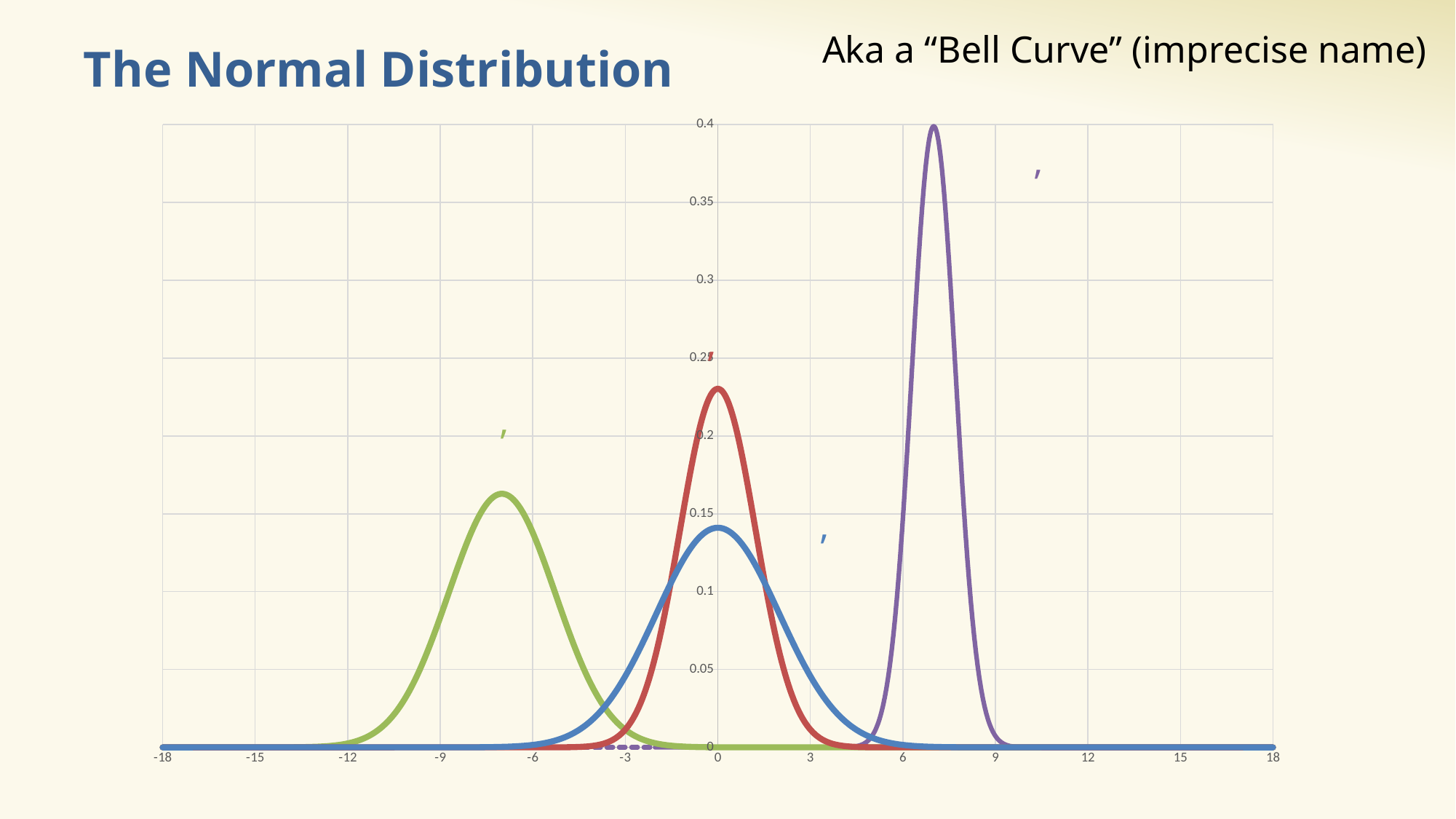
Which curve reaches the highest peak? the purple curve What is the highest value shown on the y axis? 0.4 What is the title of the chart slide? The Normal Distribution How many curves are plotted on the chart? 4 Is the peak of the green curve greater or less than 0.2? less Is the peak of the blue curve greater or less than 0.15? less Is the peak of the purple curve greater or less than 0.35? greater Which curve has the lowest peak? the blue curve What kind of chart is shown on the slide? line chart Which has the higher peak, the red curve or the blue curve? the red curve Which curve peaks furthest to the left on the x axis? the green curve